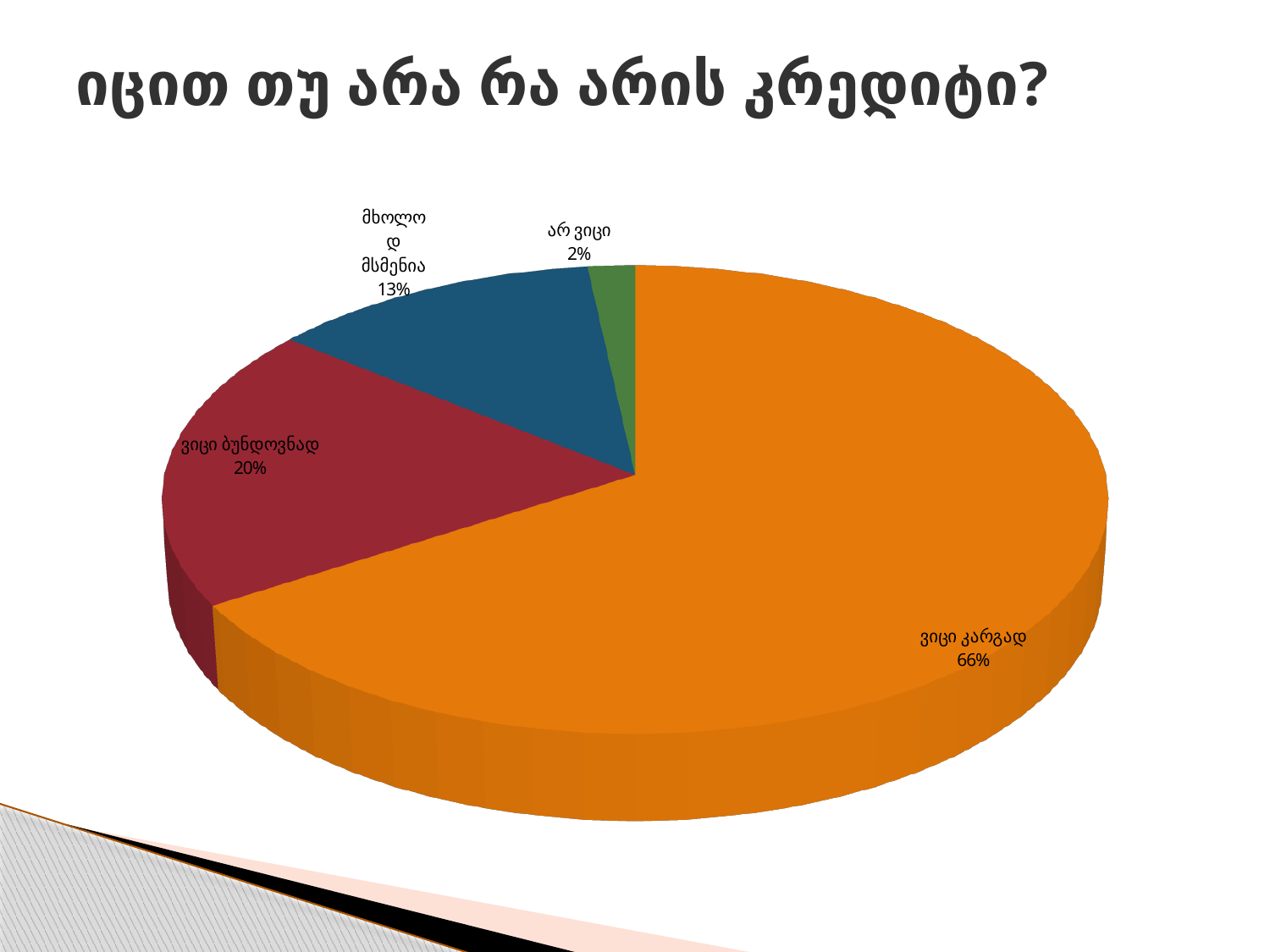
Which slice of the pie is the largest? ვიცი კარგად How many slices does the pie chart have? 4 What kind of chart is shown on the slide? Pie chart What percentage is shown for the slice "მხოლოდ მსმენია"? 13% What percentage is shown for the slice "ვიცი ბუნდოვნად"? 20% What is the difference in percentage points between "ვიცი კარგად" and "ვიცი ბუნდოვნად"? 46 What percentage is shown for the slice "არ ვიცი"? 2% Which slice of the pie is the smallest? არ ვიცი What is the difference in percentage points between "ვიცი ბუნდოვნად" and "მხოლოდ მსმენია"? 7 What colour is the slice labelled "ვიცი კარგად"? Orange Which is larger, the slice for "მხოლოდ მსმენია" or the slice for "არ ვიცი"? მხოლოდ მსმენია What share of the pie does the slice labelled "ვიცი კარგად" represent? 66%